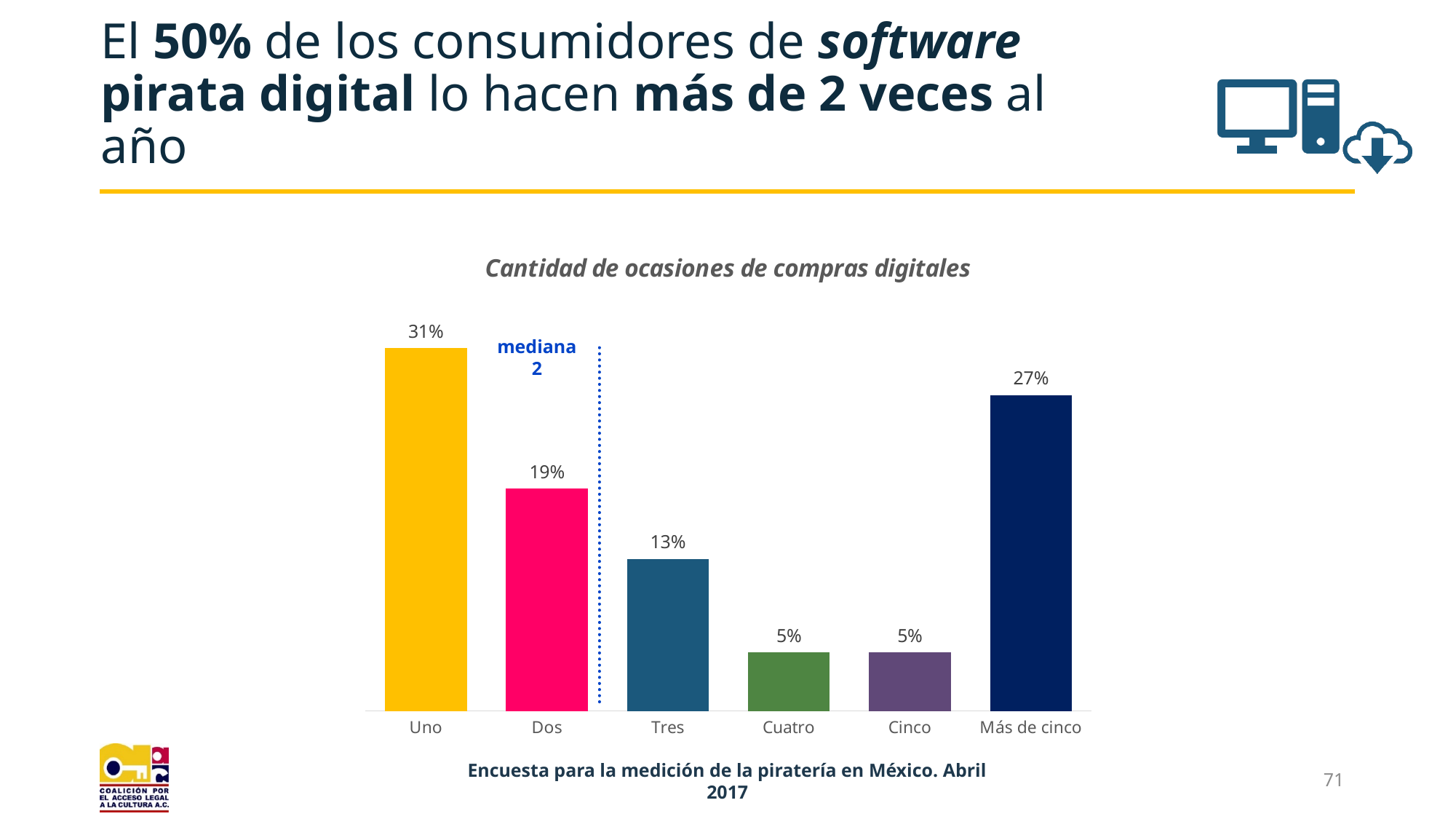
What is the title of the chart? Cantidad de ocasiones de compras digitales What is the value for "Uno"? 31% What is the combined value of "Cuatro" and "Cinco"? 10% What kind of chart is shown on the slide? Bar chart Which is larger, the value for "Dos" or the value for "Más de cinco"? Más de cinco What is the value for "Más de cinco"? 27% What median value is marked by the dotted line on the chart? 2 What is the value for "Tres"? 13% How many categories are shown on the x axis? 6 Which category has the highest value? Uno What is the difference between the values for "Tres" and "Cuatro"? 8% What is the difference between the values for "Uno" and "Dos"? 12%